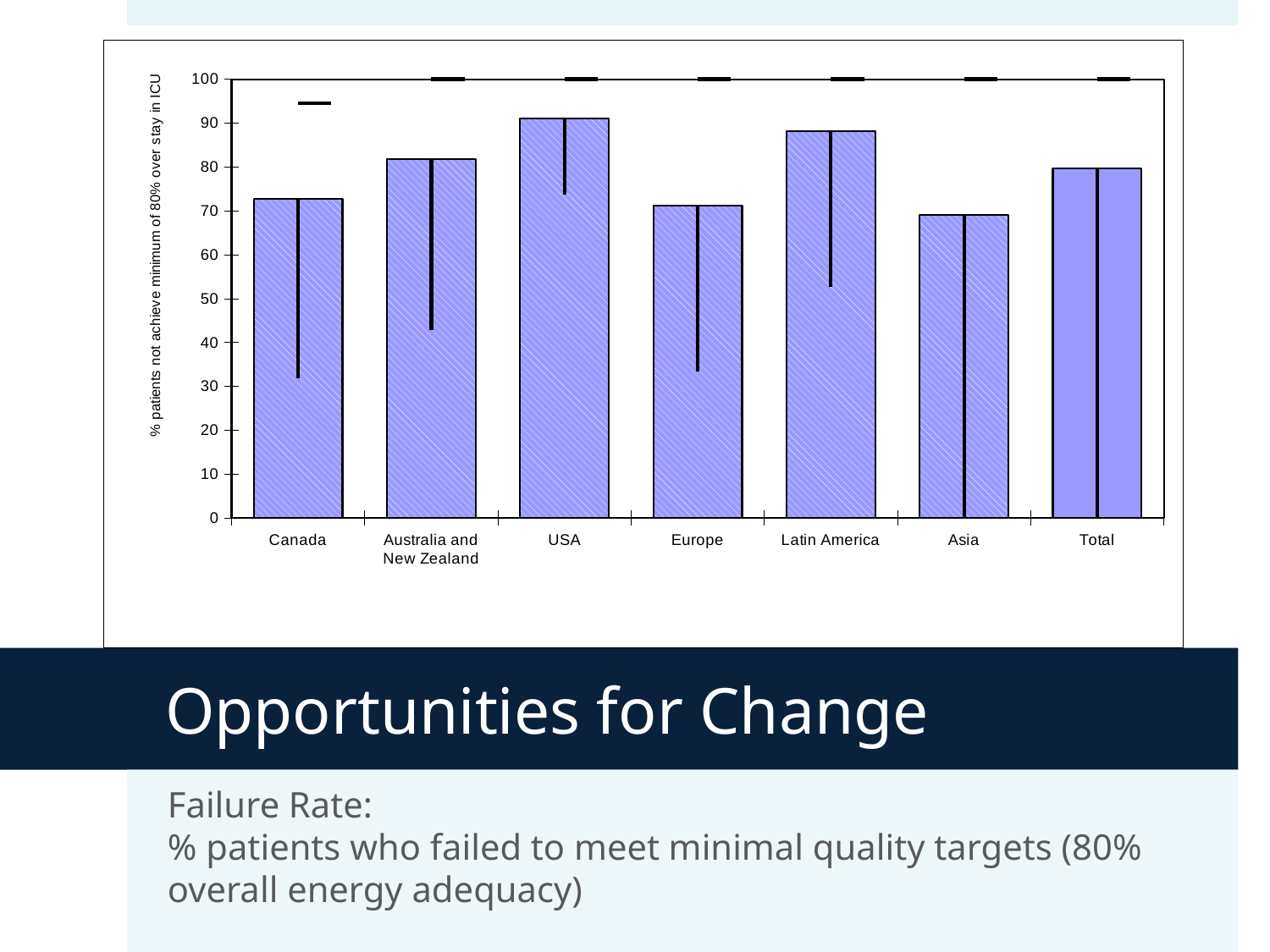
Is the value for Europe greater or less than 80? less Is the value for Latin America greater or less than 80? greater Is the value for Canada greater or less than 80? less Which is larger, the value for USA or the value for Canada? USA What kind of chart is shown on the slide? bar chart How many categories are shown on the x axis of the chart? 7 Which category has the highest bar in the chart? USA Which is larger, the value for Latin America or the value for Asia? Latin America What is the label on the y axis of the chart? % patients not achieve minimum of 80% over stay in ICU